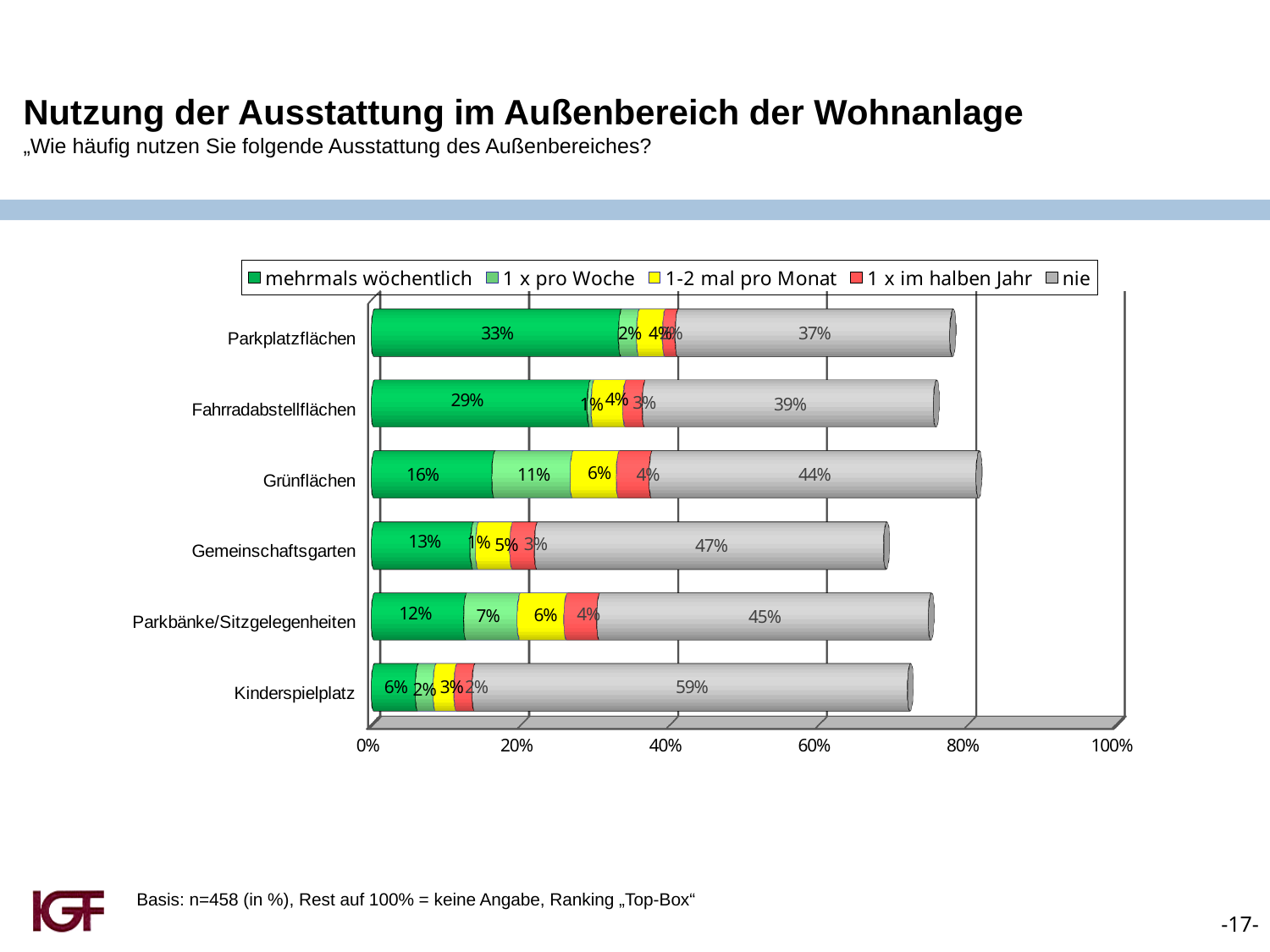
What kind of chart is shown on the slide? Stacked bar chart Which category has the lowest value for "mehrmals wöchentlich"? Kinderspielplatz What is the value for "mehrmals wöchentlich" for Grünflächen? 16% Which category has the highest value for "nie"? Kinderspielplatz Which has the larger "1 x pro Woche" value, Grünflächen or Parkbänke/Sitzgelegenheiten? Grünflächen How many categories (facilities) are plotted on the chart? 6 How many series does the legend list? 5 Which category has the highest value for "mehrmals wöchentlich"? Parkplatzflächen What is the total of the stacked bar for Grünflächen? 81% What is the difference between the "mehrmals wöchentlich" values for Parkplatzflächen and Fahrradabstellflächen? 4 percentage points What is the value for "nie" for Kinderspielplatz? 59% What is the value for "1-2 mal pro Monat" for Gemeinschaftsgarten? 5%